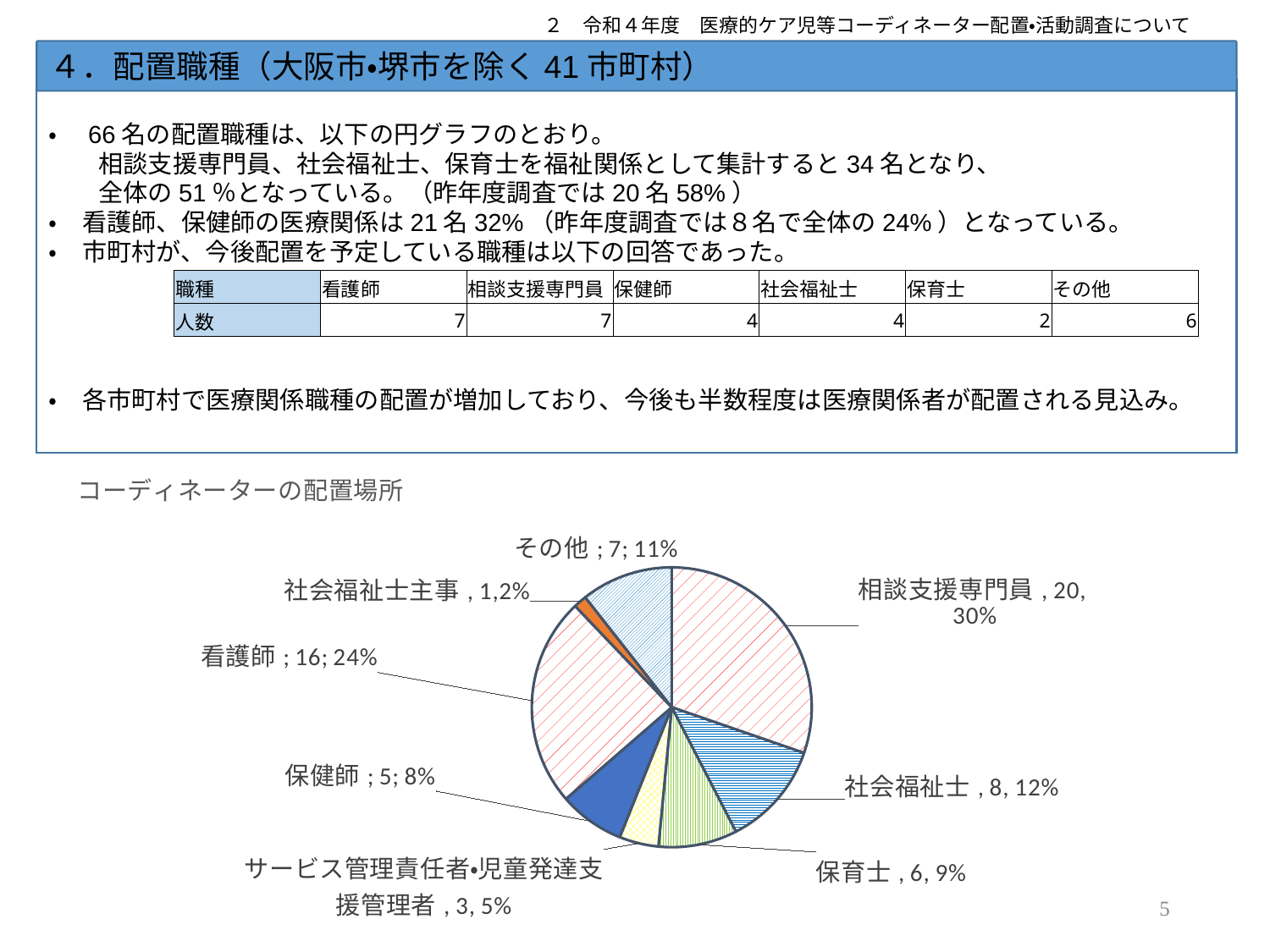
What percentage share does 看護師 have in the pie chart? 24% What is the value for 保健師 in the pie chart? 5 What is the value for 相談支援専門員 in the pie chart? 20 Which category has the largest slice in the pie chart? 相談支援専門員 How many slices does the pie chart have? 8 What is the title of the chart on the slide? コーディネーターの配置場所 Which category has the smallest slice in the pie chart? 社会福祉士主事 What is the value for サービス管理責任者・児童発達支援管理者 in the pie chart? 3 What percentage share does その他 have in the pie chart? 11% Which is larger in the pie chart, 社会福祉士 or 保育士? 社会福祉士 What is the difference between the values for 相談支援専門員 and 看護師 in the pie chart? 4 What kind of chart is shown on the slide? pie chart